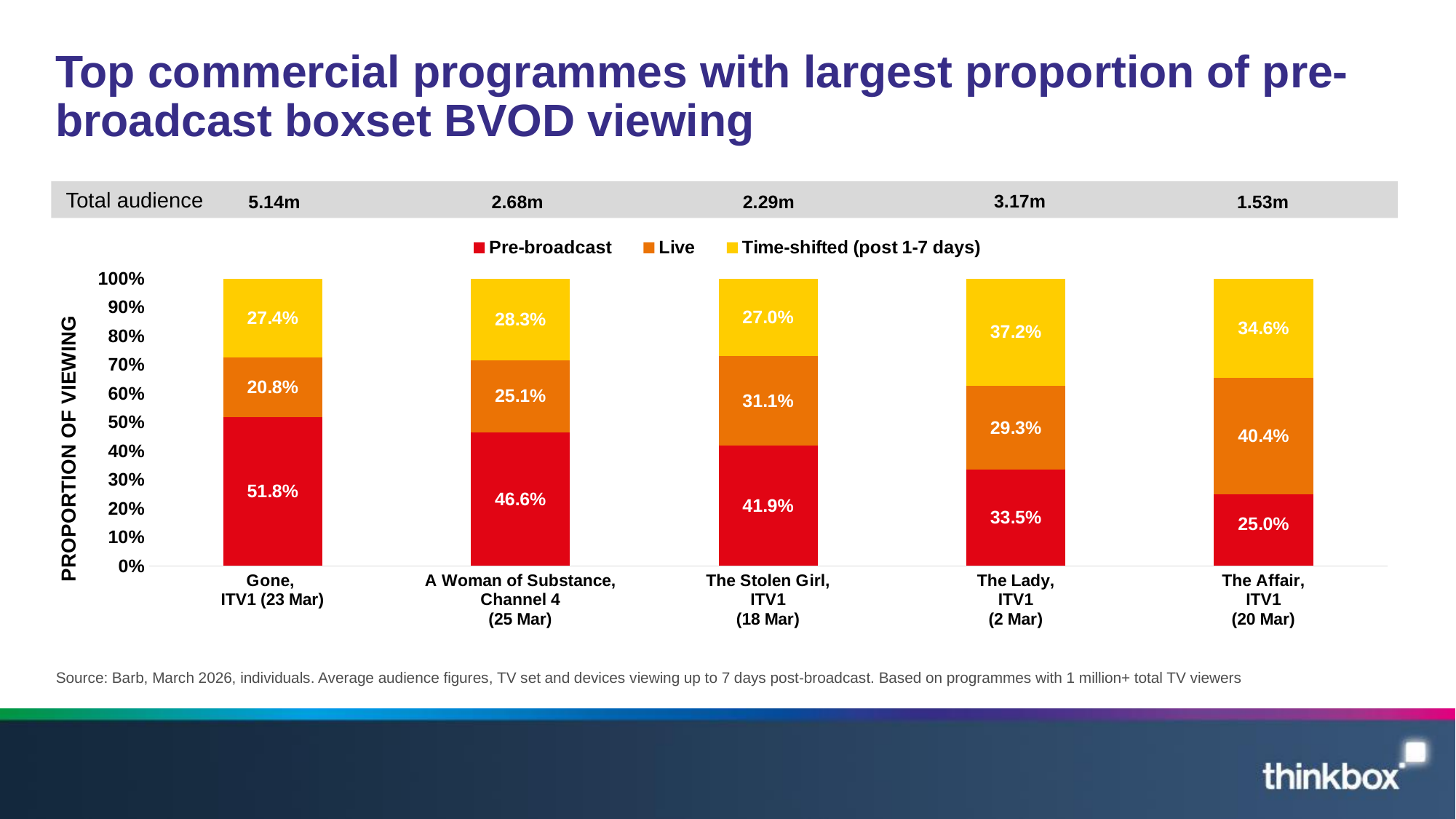
What is the difference between the Pre-broadcast proportions for Gone and A Woman of Substance? 5.2% How many programmes are shown on the chart? 5 What is the total audience shown for The Lady, ITV1 (2 Mar)? 3.17m What kind of chart is shown on the slide? Stacked bar chart How many series does the legend list? 3 Which is larger: the Live proportion for The Stolen Girl or the Live proportion for The Lady? The Stolen Girl What is the Live proportion of viewing for The Affair, ITV1 (20 Mar)? 40.4% Which programme has the highest Pre-broadcast proportion of viewing? Gone, ITV1 (23 Mar) What is the Pre-broadcast proportion of viewing for Gone, ITV1 (23 Mar)? 51.8% What is the Time-shifted (post 1-7 days) proportion for The Lady, ITV1 (2 Mar)? 37.2% Does the Pre-broadcast proportion rise or fall moving from left to right across the programmes? Fall Which programme has the lowest Pre-broadcast proportion of viewing? The Affair, ITV1 (20 Mar)